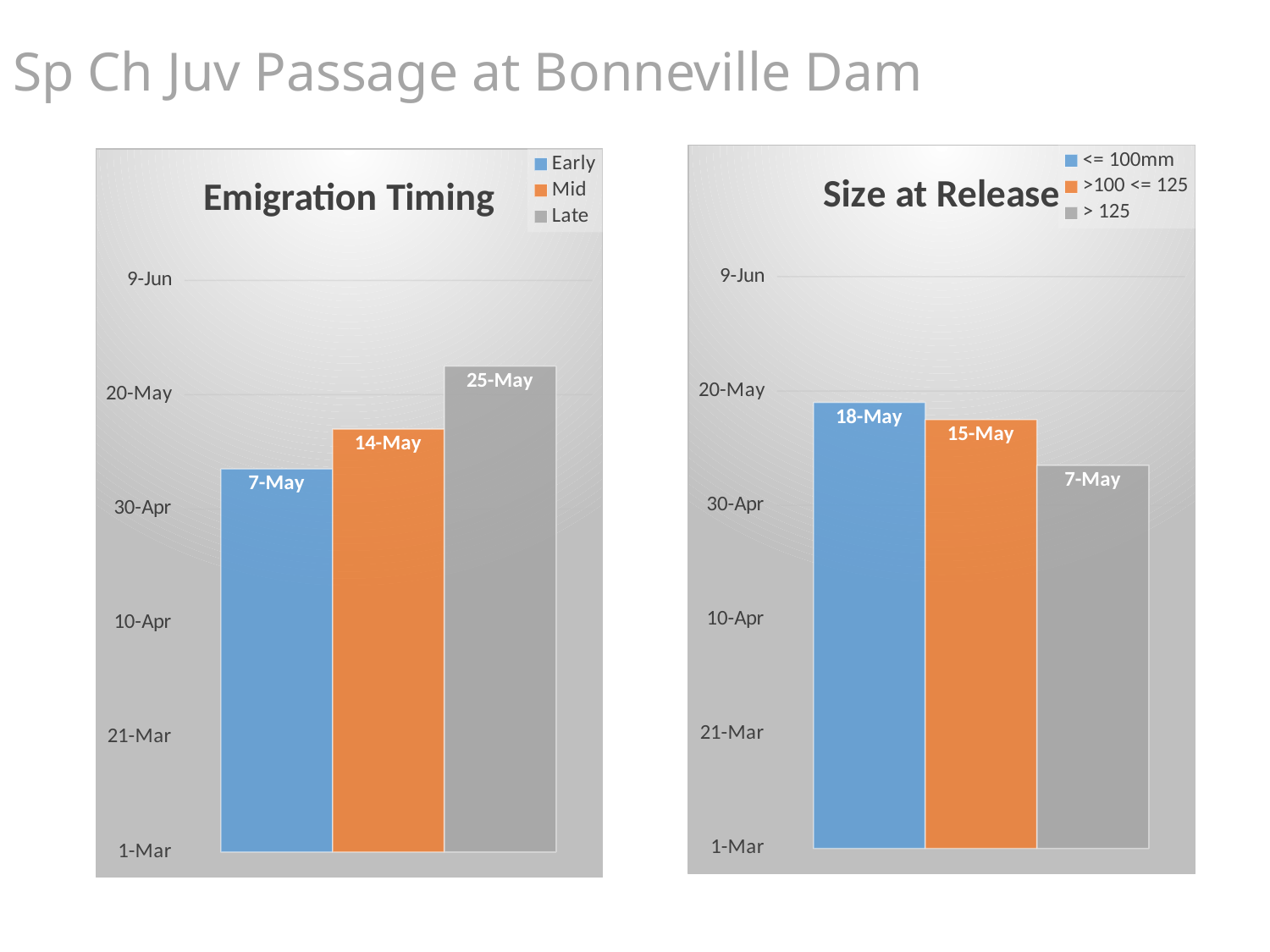
In the Emigration Timing chart, which series has the latest date? Late In the Emigration Timing chart, how many series does the legend list? 3 In the Size at Release chart, what is the value for > 125? 7-May In the Size at Release chart, what is the value for >100 <= 125? 15-May In the Size at Release chart, do the values rise or fall from left to right? fall In the Emigration Timing chart, what is the value for Late? 25-May In the Emigration Timing chart, which series has the earliest date? Early In the Emigration Timing chart, what is the value for Early? 7-May In the Size at Release chart, which series has the earliest date? > 125 What kind of chart is the Size at Release chart? bar chart In the Size at Release chart, is the value for <= 100mm later or earlier than 20-May? earlier In the Size at Release chart, what is the value for <= 100mm? 18-May